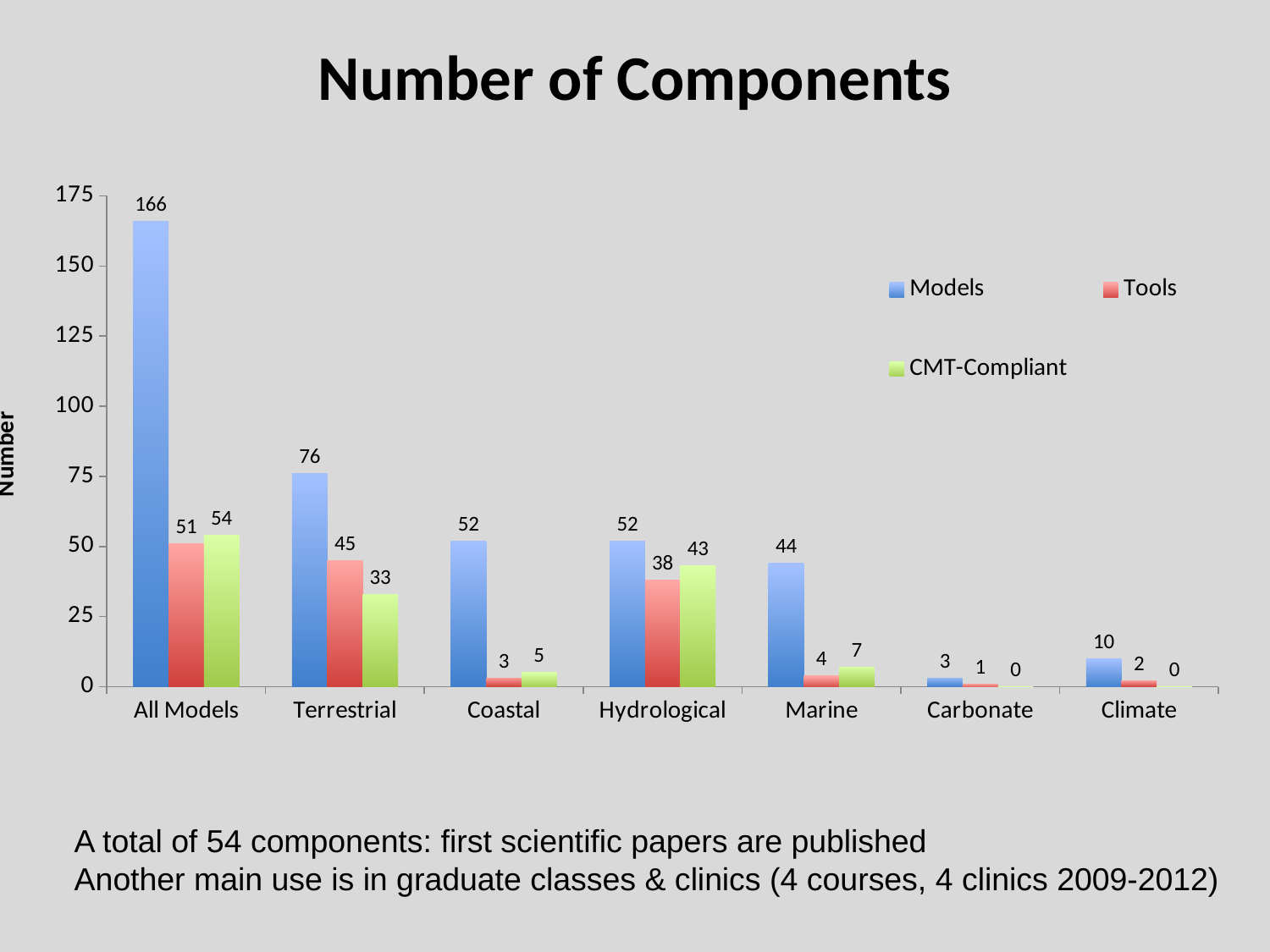
What kind of chart is shown on the slide? Bar chart How many categories are shown on the x axis? 7 What is the value for CMT-Compliant in the Hydrological category? 43 What is the value for CMT-Compliant in the Climate category? 0 Which category has the highest value for Models? All Models What is the title of the chart? Number of Components What is the value for Tools in the Terrestrial category? 45 How many series does the legend list? 3 What is the value for Models in the All Models category? 166 Which category has the lowest value for Models? Carbonate Which is larger in the Marine category, Tools or CMT-Compliant? CMT-Compliant What is the difference between the Models value and the Tools value in the Terrestrial category? 31